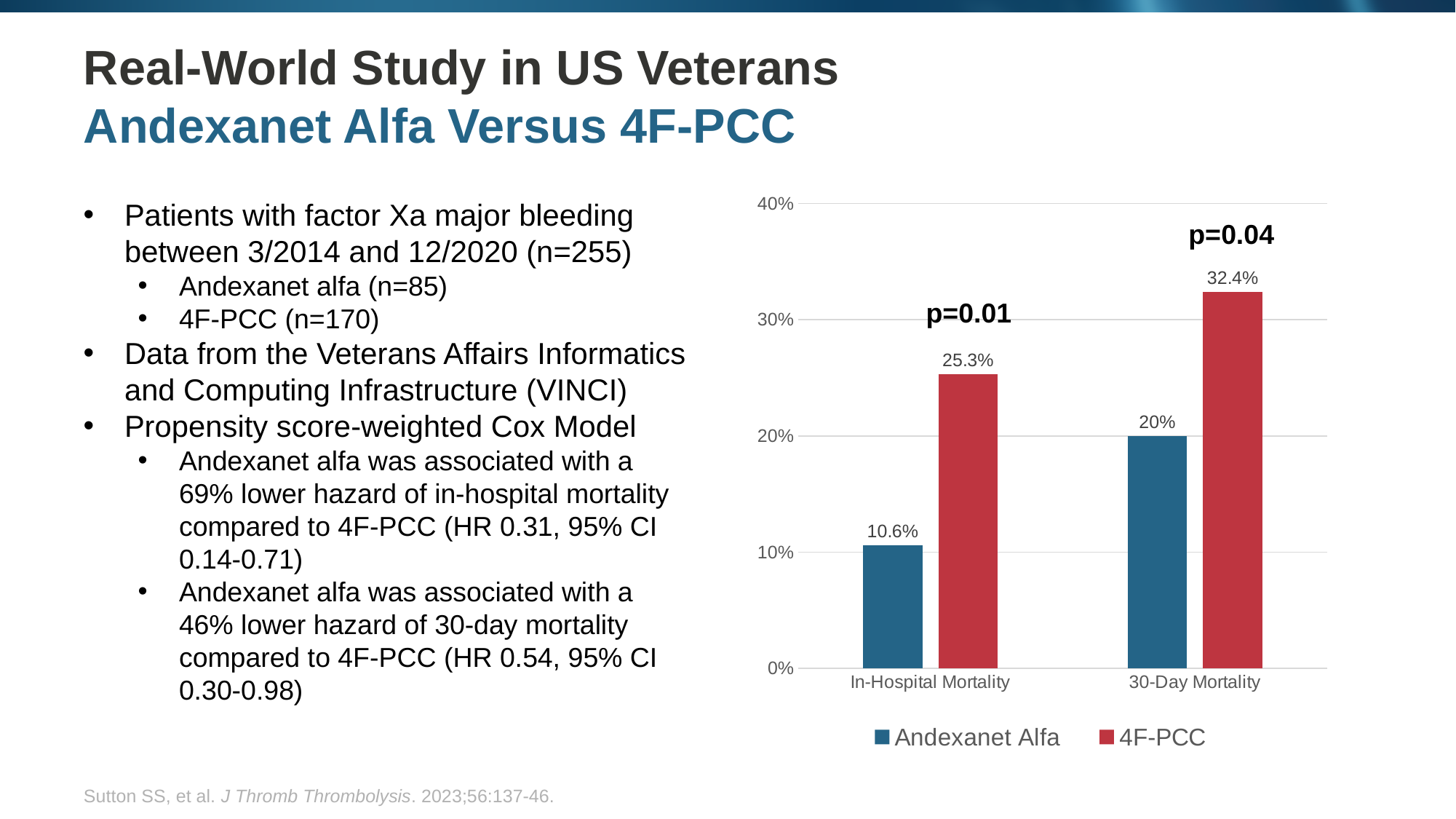
How many categories are shown on the x axis of the chart? 2 What is the 30-day mortality value for 4F-PCC? 32.4% What is the difference between the 4F-PCC and Andexanet Alfa values for 30-day mortality? 12.4% What is the in-hospital mortality value for Andexanet Alfa? 10.6% For 30-day mortality, which series has the larger value, Andexanet Alfa or 4F-PCC? 4F-PCC Which bar in the chart has the lowest value? Andexanet Alfa, In-Hospital Mortality What kind of chart is shown on the slide? Bar chart How many series does the chart legend list? 2 Which bar in the chart has the highest value? 4F-PCC, 30-Day Mortality What is the in-hospital mortality value for 4F-PCC? 25.3% What is the difference between the 4F-PCC and Andexanet Alfa values for in-hospital mortality? 14.7% What is the 30-day mortality value for Andexanet Alfa? 20%